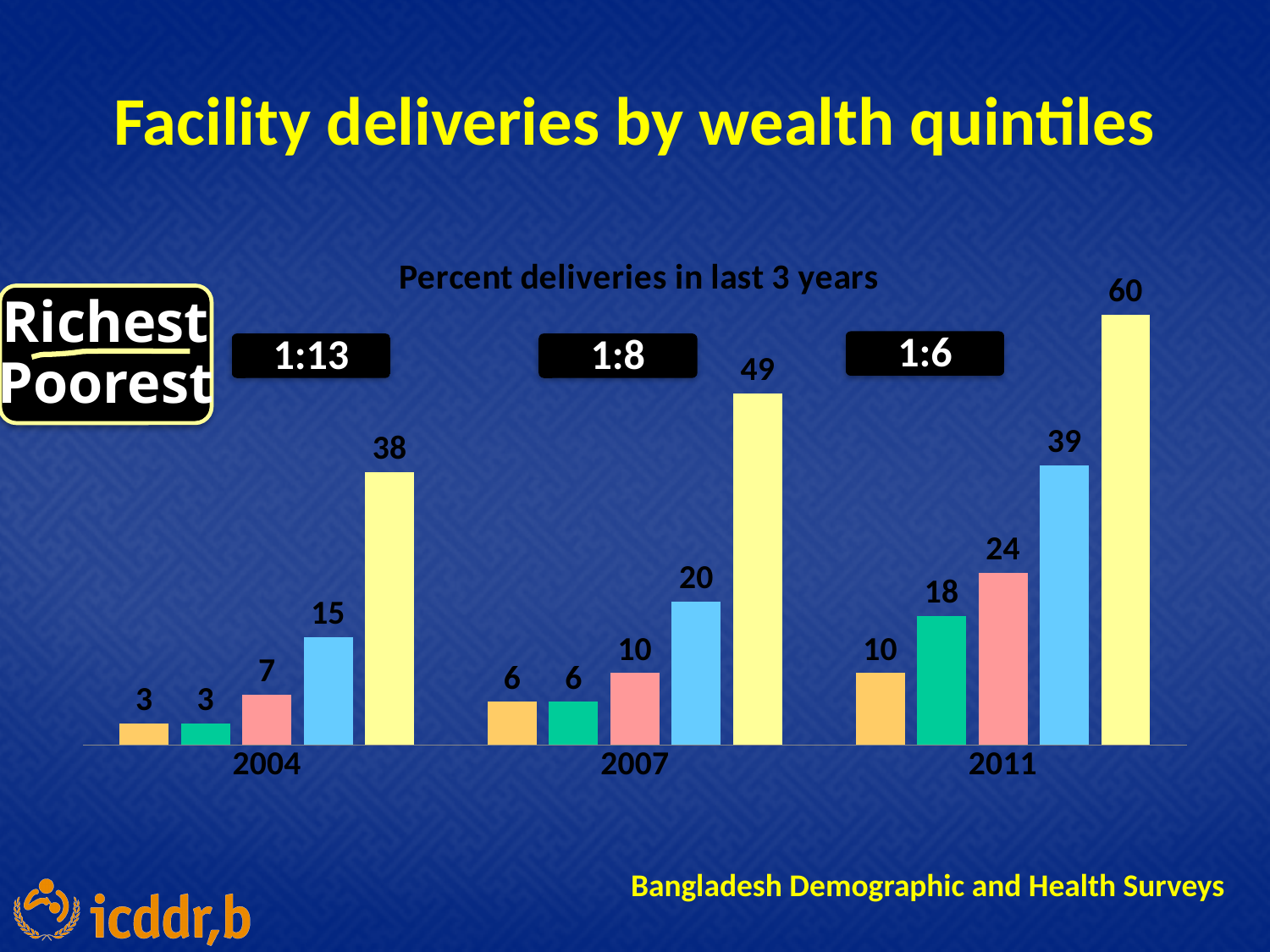
Is the pink bar for 2011 larger or smaller than the pink bar for 2007? larger What is the value of the tallest (yellow) bar for 2011? 60 What is the value of the tallest (yellow) bar for 2004? 38 Does the value of the yellow bar rise or fall from 2004 to 2011? rise Which year has the highest value for the yellow bar? 2011 What is the value of the light blue bar for 2007? 20 How many year groups are shown on the x axis? 3 What is the chart title shown above the bars? Percent deliveries in last 3 years What type of chart is shown on the slide? bar chart What is the value of the first (orange) bar for 2011? 10 What is the difference between the yellow bar values for 2011 and 2004? 22 How many bars are in each year group? 5